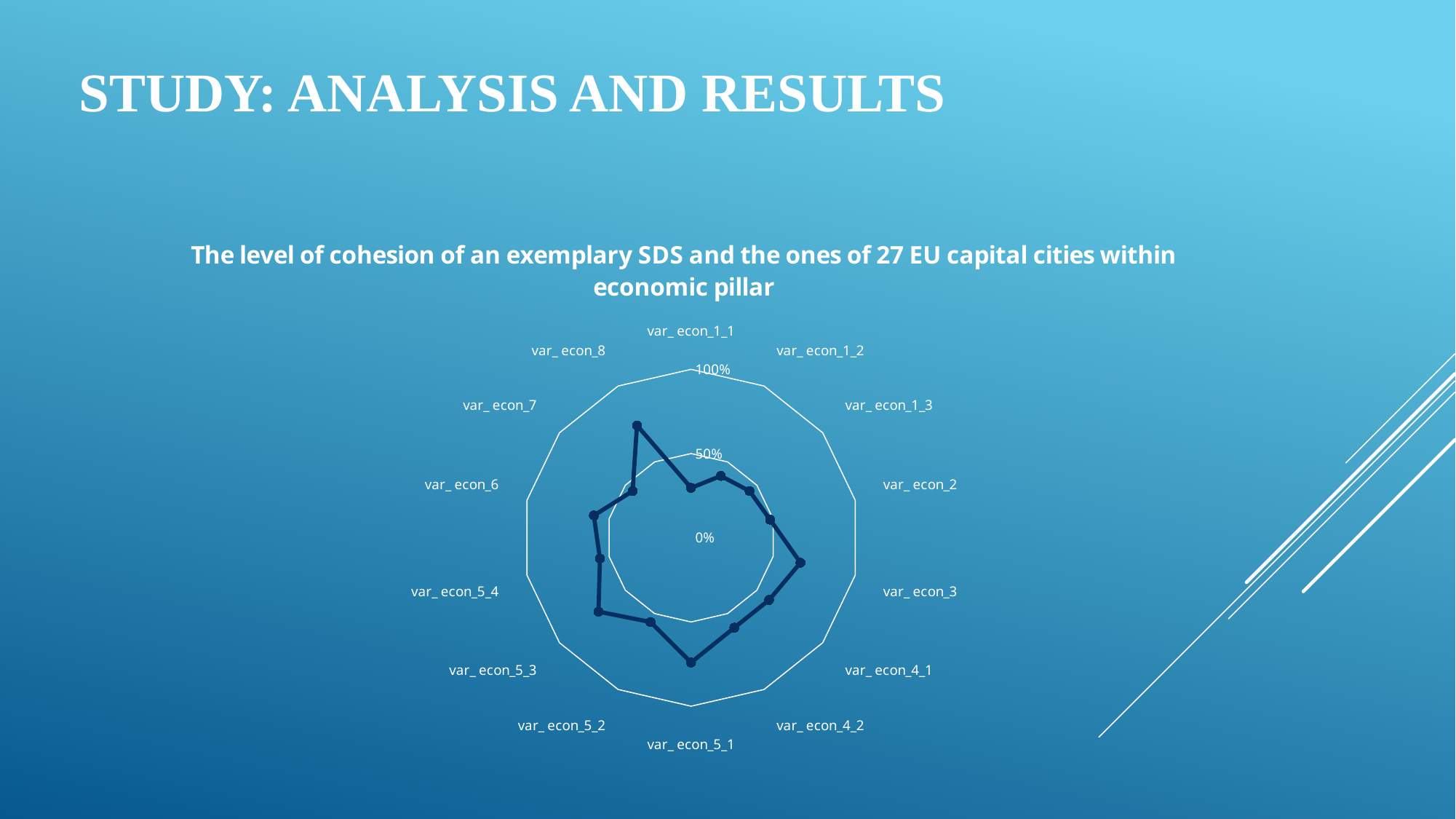
Is the value for var_econ_1_1 greater or less than 50%? less What kind of chart is shown on the slide? Radar chart How many categories (axes) does the radar chart have? 14 Is the value for var_econ_5_3 greater or less than 50%? greater Is the value for var_econ_8 greater or less than 50%? greater Which has the larger value, var_econ_8 or var_econ_2? var_econ_8 What is the title of the chart? The level of cohesion of an exemplary SDS and the ones of 27 EU capital cities within economic pillar Which has the larger value, var_econ_5_1 or var_econ_1_1? var_econ_5_1 What is the maximum value shown on the chart's radial axis? 100%